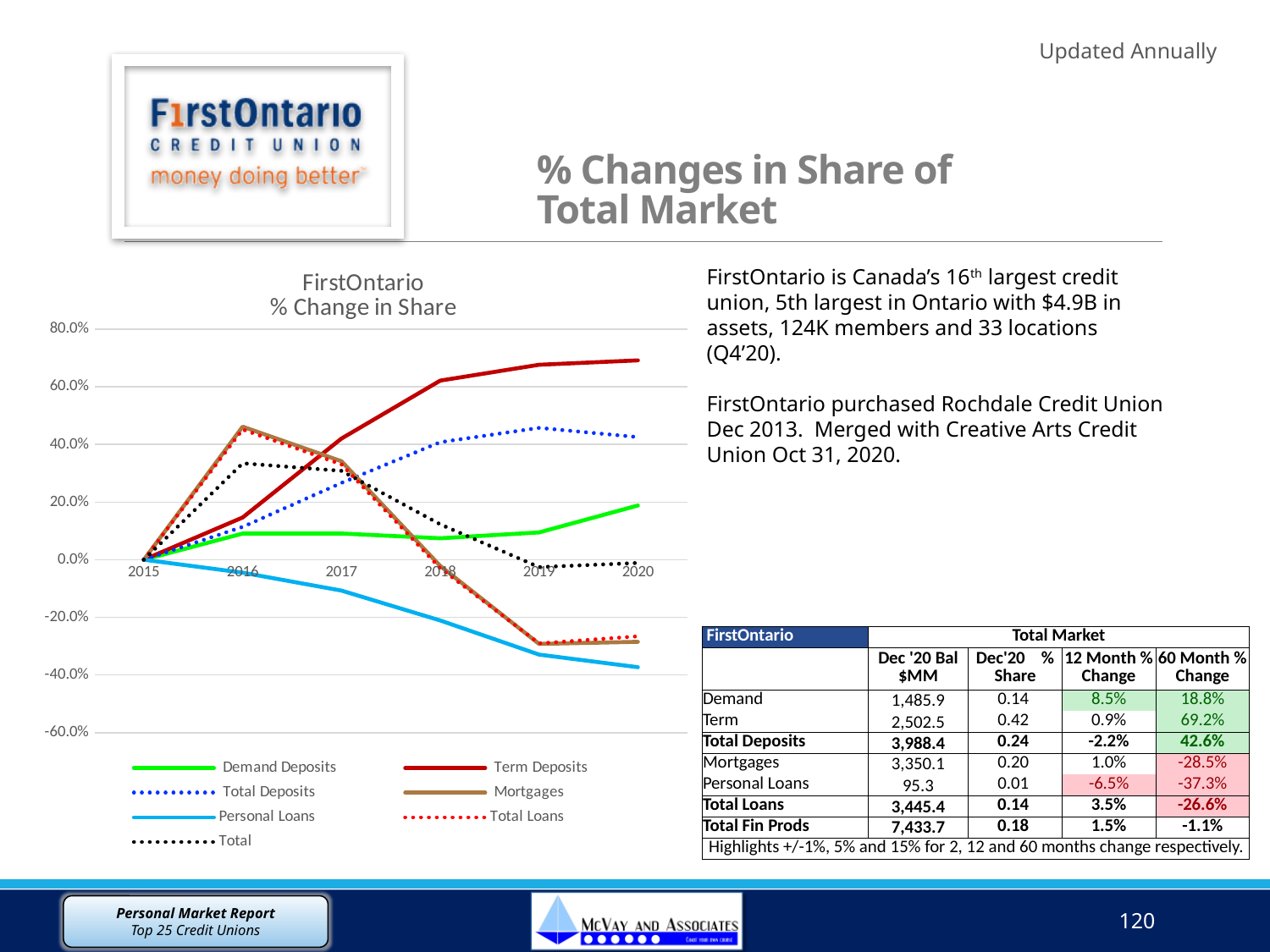
Is the value for Personal Loans in 2020 greater or less than -20.0%? less How many years are plotted along the x axis of the chart? 6 Does the Term Deposits line rise or fall from 2015 to 2020? rises Does the Personal Loans line rise or fall from 2015 to 2020? falls Which series has the highest value in 2020? Term Deposits What kind of chart is shown on the slide? line chart Which series has the lowest value in 2020? Personal Loans How many series does the chart's legend list? 7 In 2020, which is larger: Term Deposits or Total Deposits? Term Deposits What is the title of the chart? FirstOntario % Change in Share Is the value for Term Deposits in 2020 greater or less than 60.0%? greater Is the value for Mortgages in 2016 greater or less than 40.0%? greater